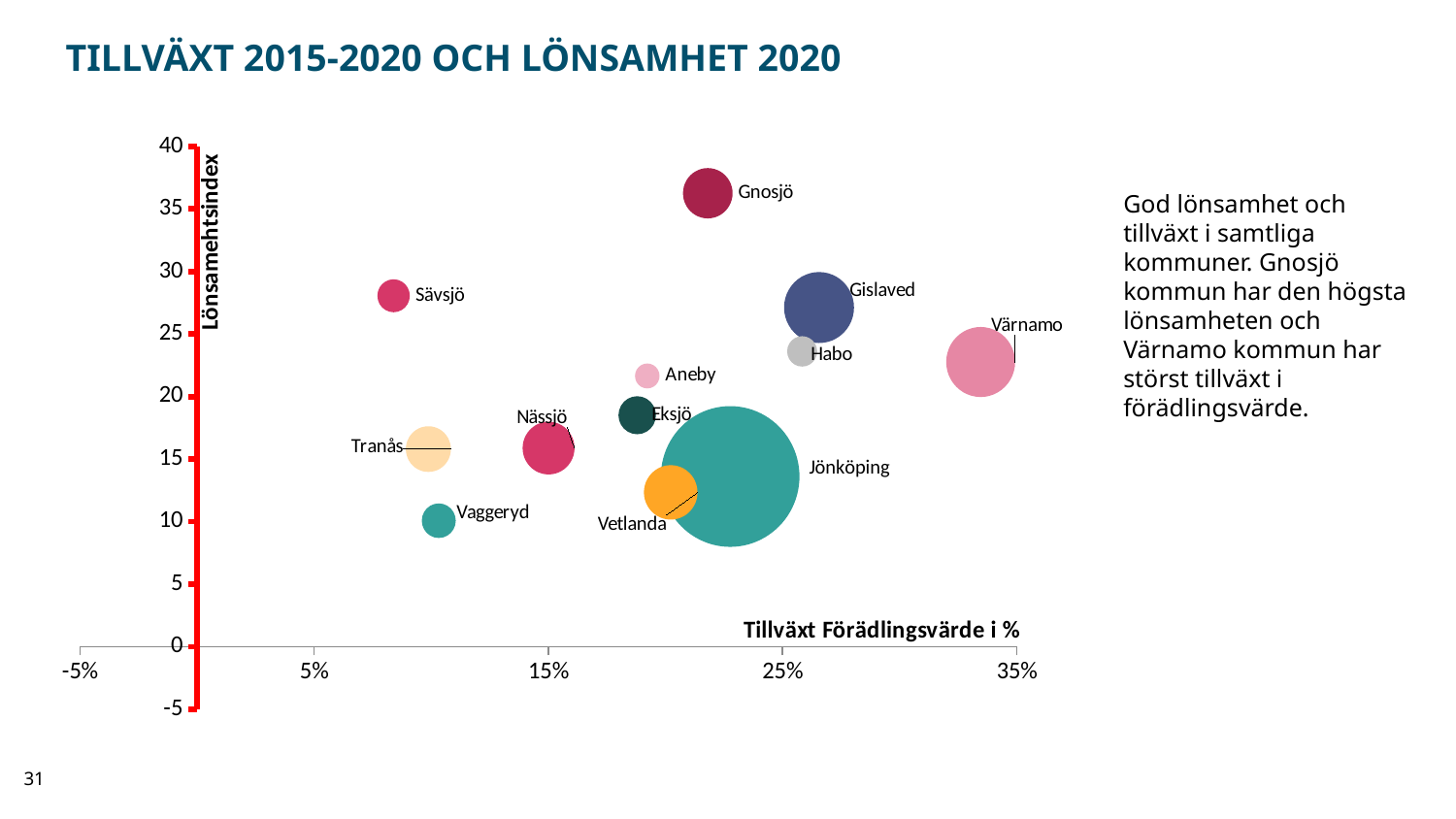
Is the tillväxt förädlingsvärde for Värnamo greater or less than 25%? greater What is the title of the horizontal axis? Tillväxt Förädlingsvärde i % How many municipalities are plotted in the chart? 12 Which municipality has the lowest tillväxt förädlingsvärde? Sävsjö Which municipality has the lowest lönsamhetsindex? Vaggeryd Which has the higher lönsamhetsindex, Gislaved or Jönköping? Gislaved What kind of chart is shown on the slide? Bubble chart Which municipality is represented by the largest bubble? Jönköping Is the lönsamhetsindex for Gnosjö greater or less than 30? greater Is the lönsamhetsindex for Vaggeryd greater or less than 15? less Which municipality has the highest tillväxt förädlingsvärde? Värnamo Which municipality has the highest lönsamhetsindex? Gnosjö